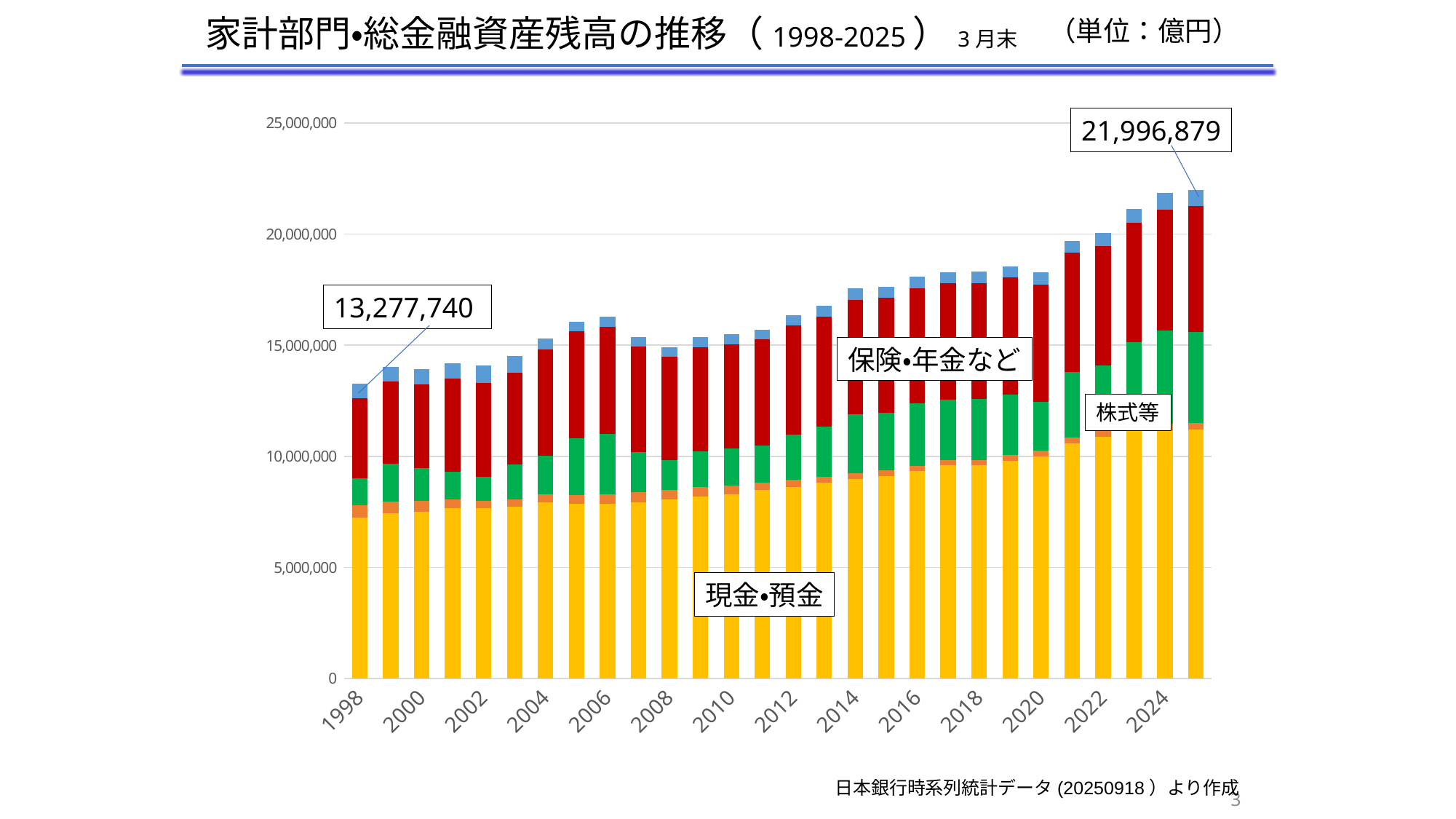
What is the total household financial asset balance shown for 2025? 21,996,879 How many years (bars) are plotted in the chart? 28 Is the total bar for 2024 greater or less than 20,000,000? greater What is the total household financial asset balance shown for 1998? 13,277,740 What kind of chart is shown on the slide? Stacked bar chart Which year has the lowest total bar in the chart? 1998 Is the total bar for 2020 greater or less than 20,000,000? less Do the total bar heights generally rise or fall from 1998 to 2025? Rise What unit is stated for the values in the chart? 億円 Which year has the larger labelled total, 1998 or 2025? 2025 What is the difference between the labelled totals for 2025 and 1998? 8,719,139 Which year has the highest total bar in the chart? 2025